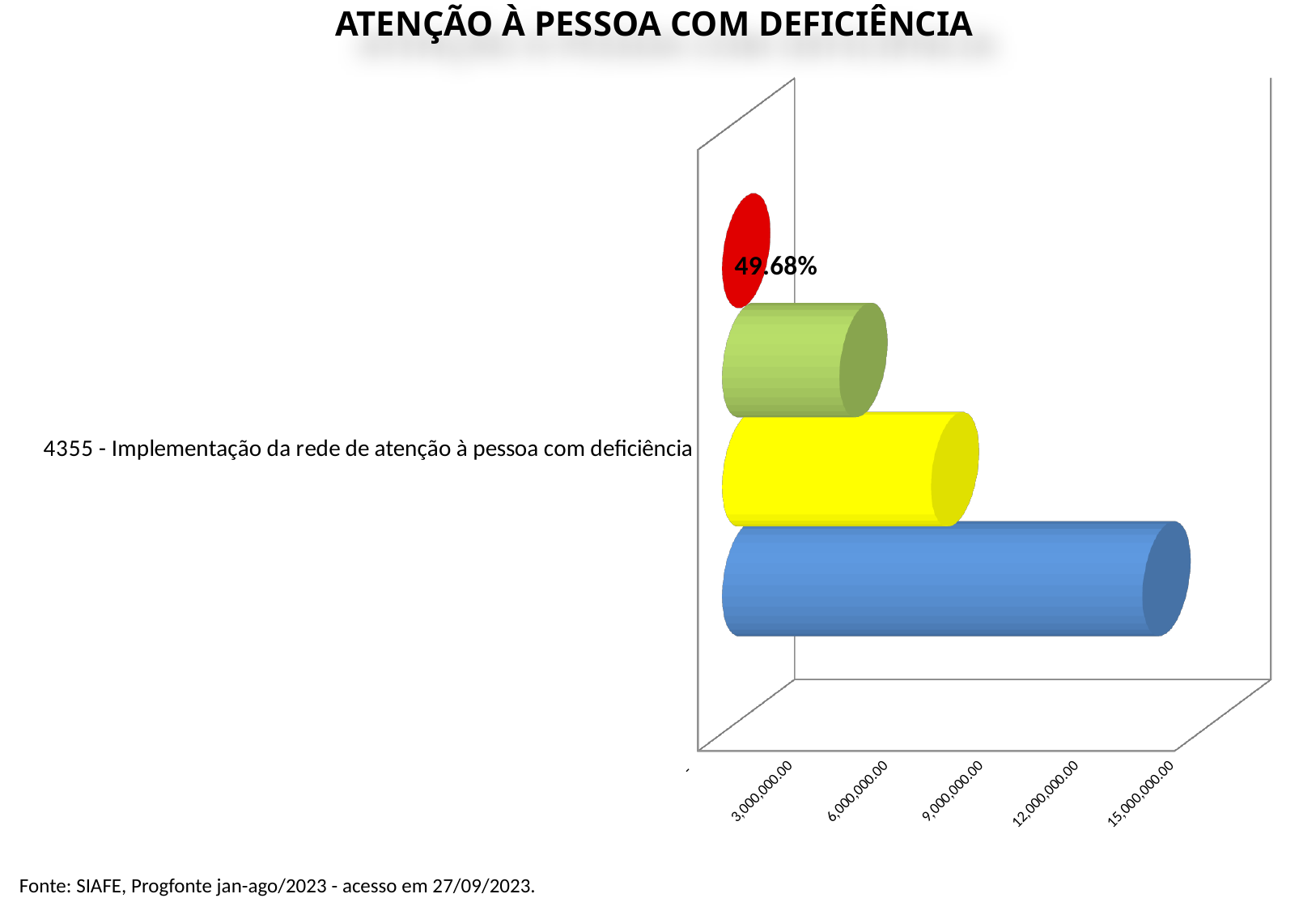
What is the category label shown on the chart? 4355 - Implementação da rede de atenção à pessoa com deficiência Which coloured bar is the longest in the chart? blue What percentage value is printed as a data label on the chart? 49.68% What is the title of the chart? ATENÇÃO À PESSOA COM DEFICIÊNCIA Which is larger, the blue bar or the yellow bar? blue bar Which coloured bar is the shortest in the chart? red How many bars are plotted for the category in the chart? 4 What kind of chart is shown on the slide? bar chart Is the value of the red bar greater or less than 3,000,000.00? less What is the highest tick value shown on the horizontal axis? 15,000,000.00 How many categories are shown on the vertical axis of the chart? 1 Is the value of the blue bar greater or less than 9,000,000.00? greater